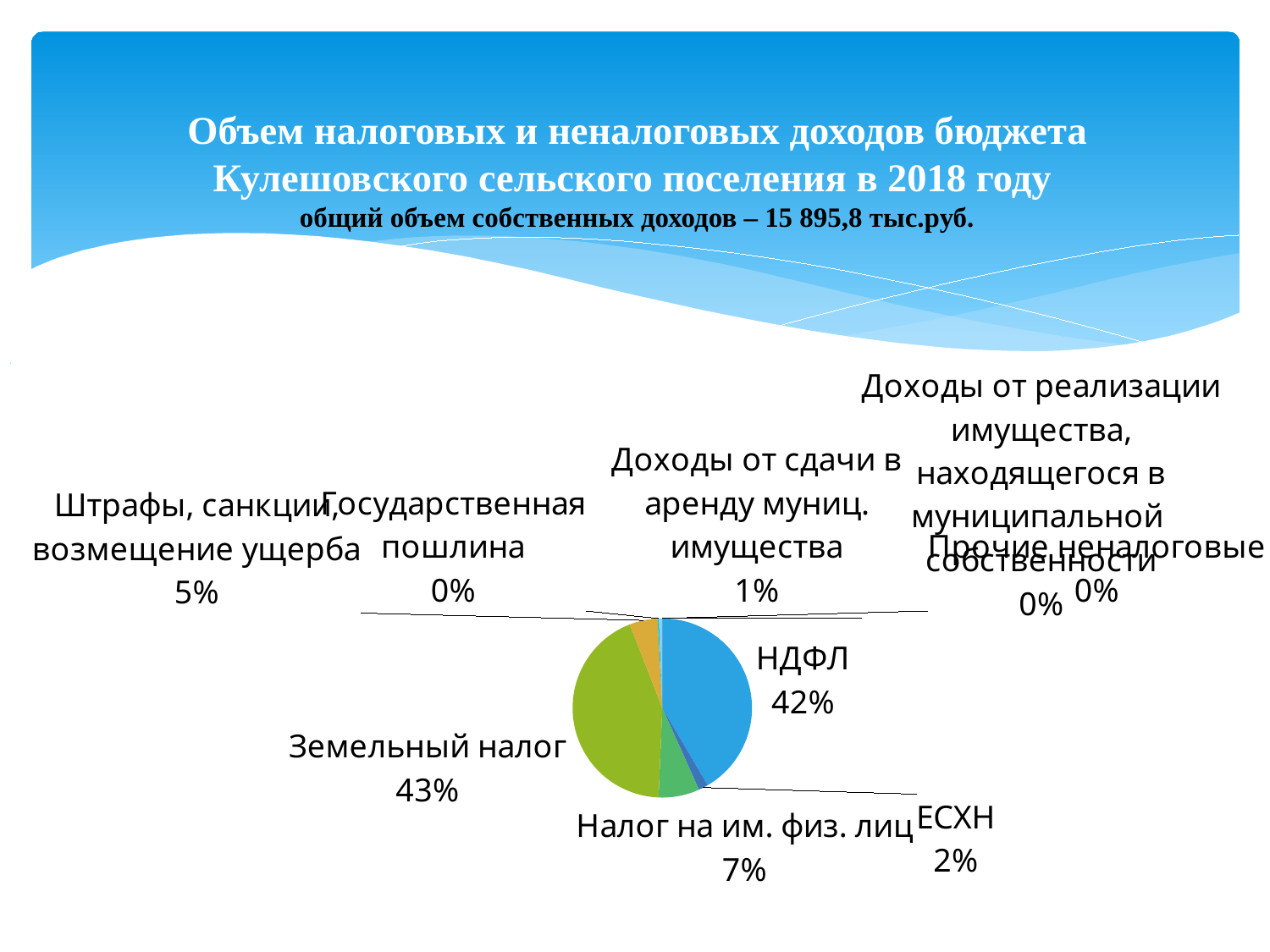
What is the value shown for Доходы от сдачи в аренду муниц. имущества? 1% What is the value shown for ЕСХН? 2% How many categories are labelled on the pie chart? 9 What is the difference between the shares of Земельный налог and НДФЛ? 1% What is the value shown for Государственная пошлина? 0% What share of the pie does НДФЛ represent? 42% Which is larger, the share for Налог на им. физ. лиц or the share for ЕСХН? Налог на им. физ. лиц What is the value shown for Штрафы, санкции, возмещение ущерба? 5% Which category has the largest share of the pie? Земельный налог What kind of chart is shown on the slide? pie chart What is the value shown for Налог на им. физ. лиц? 7% What share of the pie does Земельный налог represent? 43%